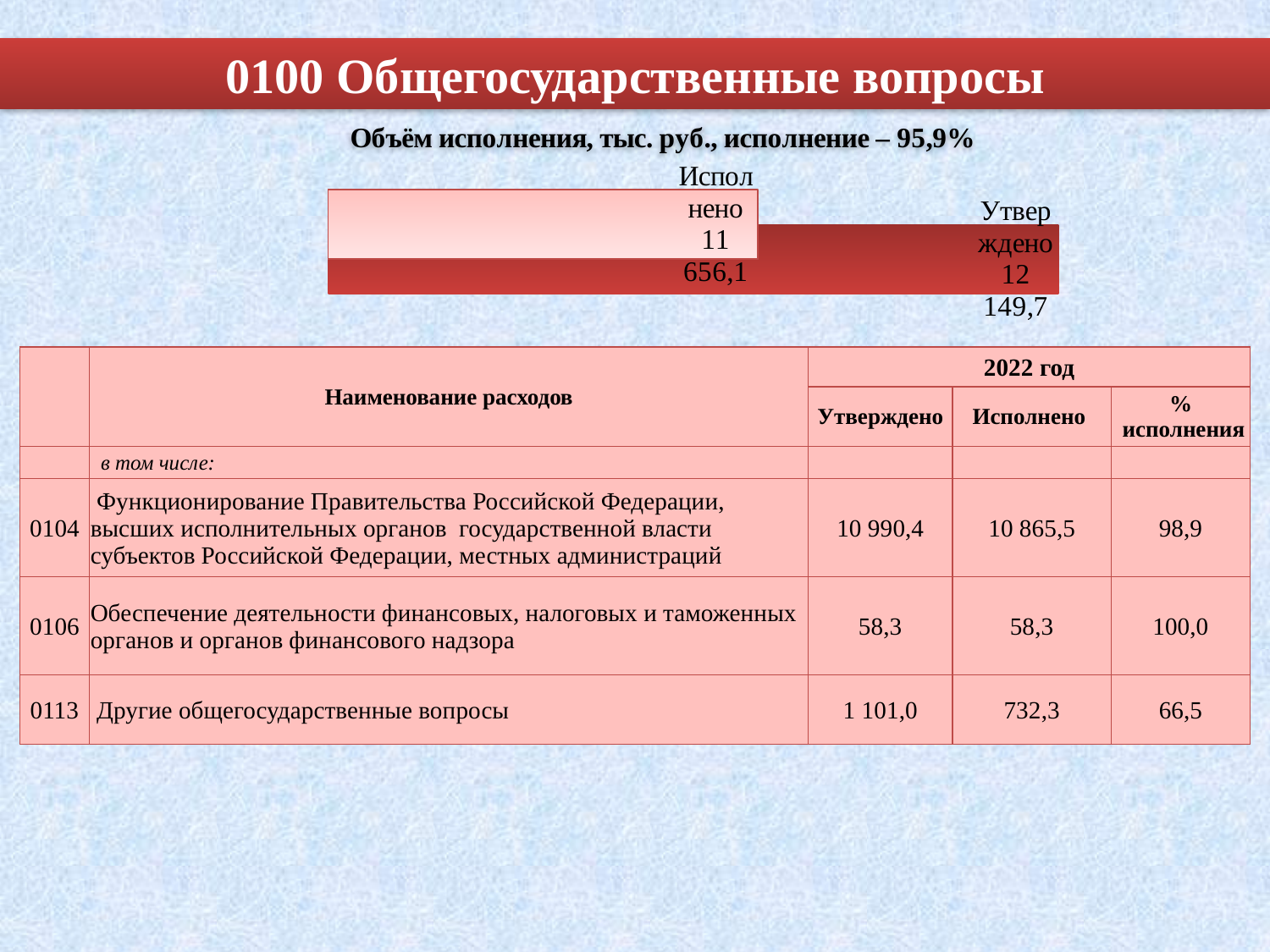
What is the title of the chart? Объём исполнения, тыс. руб., исполнение – 95,9% Which bar in the chart has the lowest value? Исполнено What execution percentage is stated in the chart title? 95,9% What is the value of the Исполнено bar in the chart? 11 656,1 Which is larger in the chart, Утверждено or Исполнено? Утверждено What kind of chart is shown on the slide? bar chart What is the difference between the Утверждено and Исполнено values in the chart? 493,6 Which bar in the chart has the highest value? Утверждено How many bars are plotted in the chart? 2 What is the value of the Утверждено bar in the chart? 12 149,7